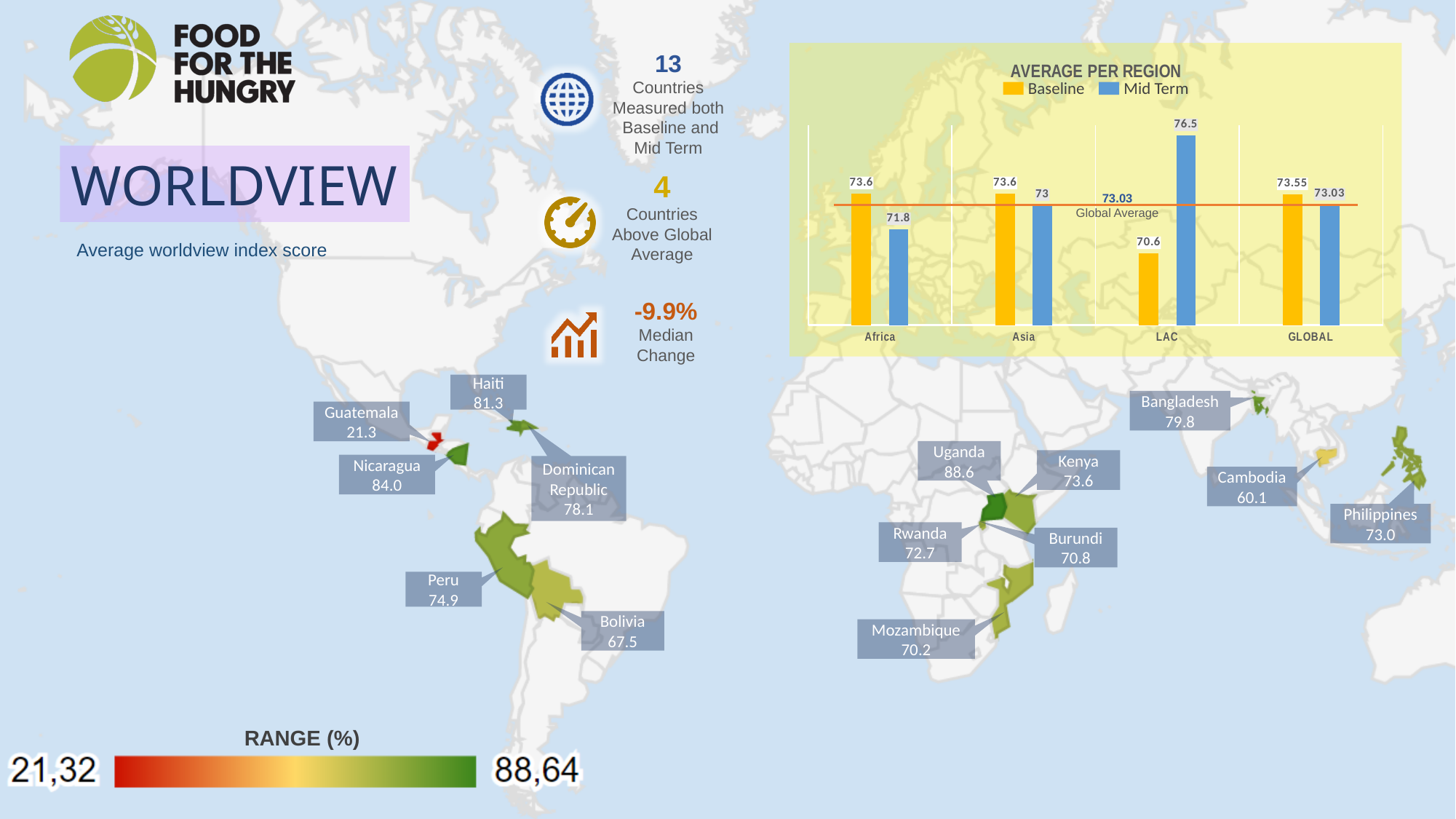
In the Average per Region chart, what is the Mid Term value for LAC? 76.5 In the Average per Region chart, is the Baseline or the Mid Term value larger for Africa? Baseline In the Average per Region chart, which region has the highest Mid Term value? LAC In the Average per Region chart, which region has the lowest Baseline value? LAC In the Average per Region chart, what is the difference between the Mid Term and Baseline values for LAC? 5.9 How many series does the legend of the Average per Region chart list? 2 In the Average per Region chart, what is the Baseline value for GLOBAL? 73.55 How many regions are shown on the x axis of the Average per Region chart? 4 In the Average per Region chart, what is the Mid Term value for Asia? 73 What kind of chart is the Average per Region chart? Bar chart In the Average per Region chart, what value is marked by the Global Average line? 73.03 In the Average per Region chart, what is the Baseline value for Africa? 73.6